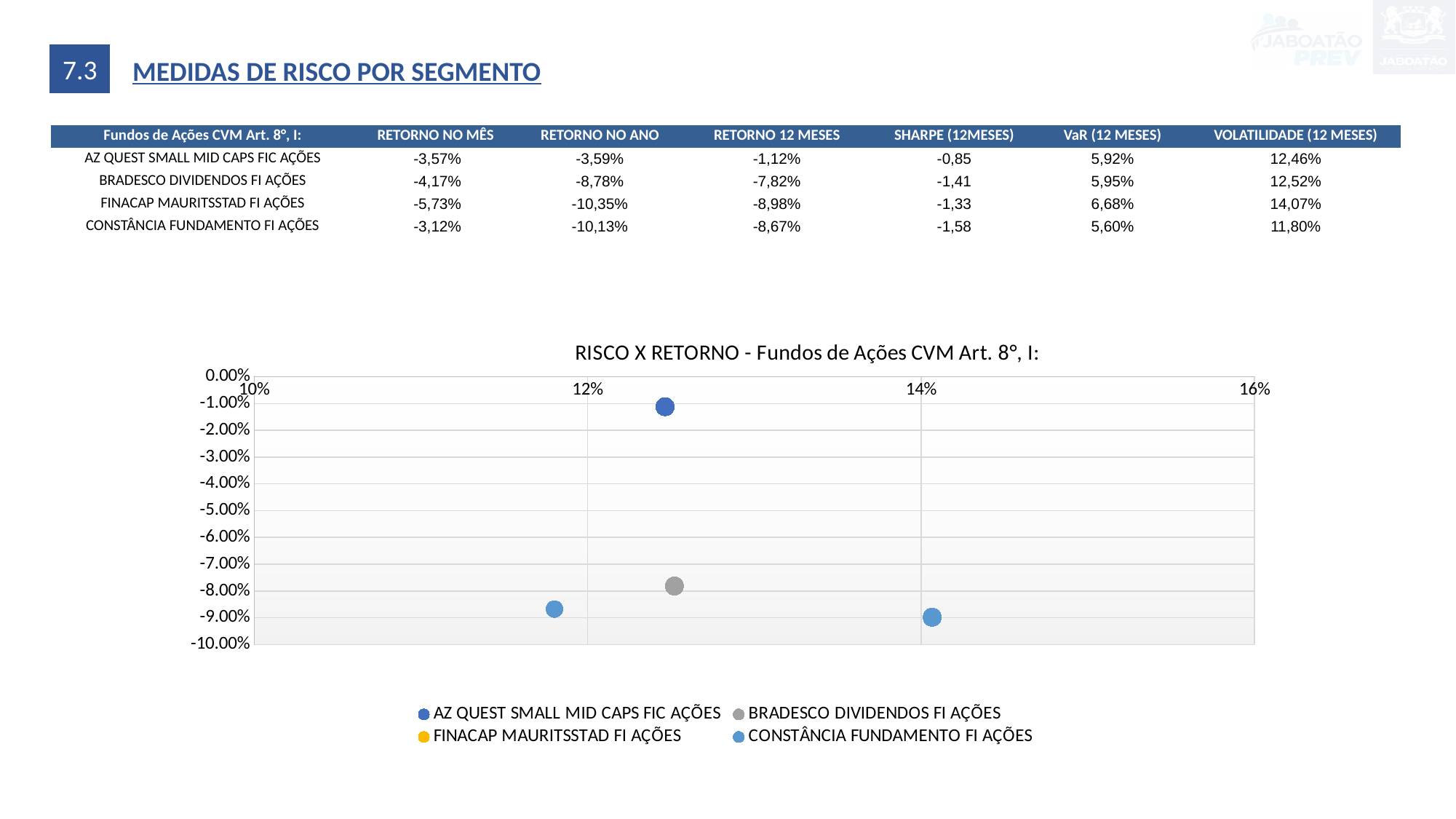
How many data points are plotted in the RISCO X RETORNO chart? 4 What is the title of the chart on the slide? RISCO X RETORNO - Fundos de Ações CVM Art. 8°, I: Which fund has the highest RETORNO 12 MESES (the highest point in the RISCO X RETORNO chart)? AZ QUEST SMALL MID CAPS FIC AÇÕES What kind of chart is shown under the title 'RISCO X RETORNO - Fundos de Ações CVM Art. 8°, I:'? scatter chart Which fund has the highest VOLATILIDADE (12 MESES) (the rightmost point in the RISCO X RETORNO chart)? FINACAP MAURITSSTAD FI AÇÕES What is the VOLATILIDADE (12 MESES) value for FINACAP MAURITSSTAD FI AÇÕES, the x-value of its point in the RISCO X RETORNO chart? 14,07% In the legend of the RISCO X RETORNO chart, what colour marks BRADESCO DIVIDENDOS FI AÇÕES? grey How many series does the legend of the RISCO X RETORNO chart list? 4 In the RISCO X RETORNO chart, is the return plotted for AZ QUEST SMALL MID CAPS FIC AÇÕES greater or less than -2.00%? greater What is the RETORNO 12 MESES value for CONSTÂNCIA FUNDAMENTO FI AÇÕES, the y-value of its point in the RISCO X RETORNO chart? -8,67% Which has the higher RETORNO 12 MESES, BRADESCO DIVIDENDOS FI AÇÕES or CONSTÂNCIA FUNDAMENTO FI AÇÕES? BRADESCO DIVIDENDOS FI AÇÕES In the RISCO X RETORNO chart, is the return plotted for BRADESCO DIVIDENDOS FI AÇÕES greater or less than -7.00%? less